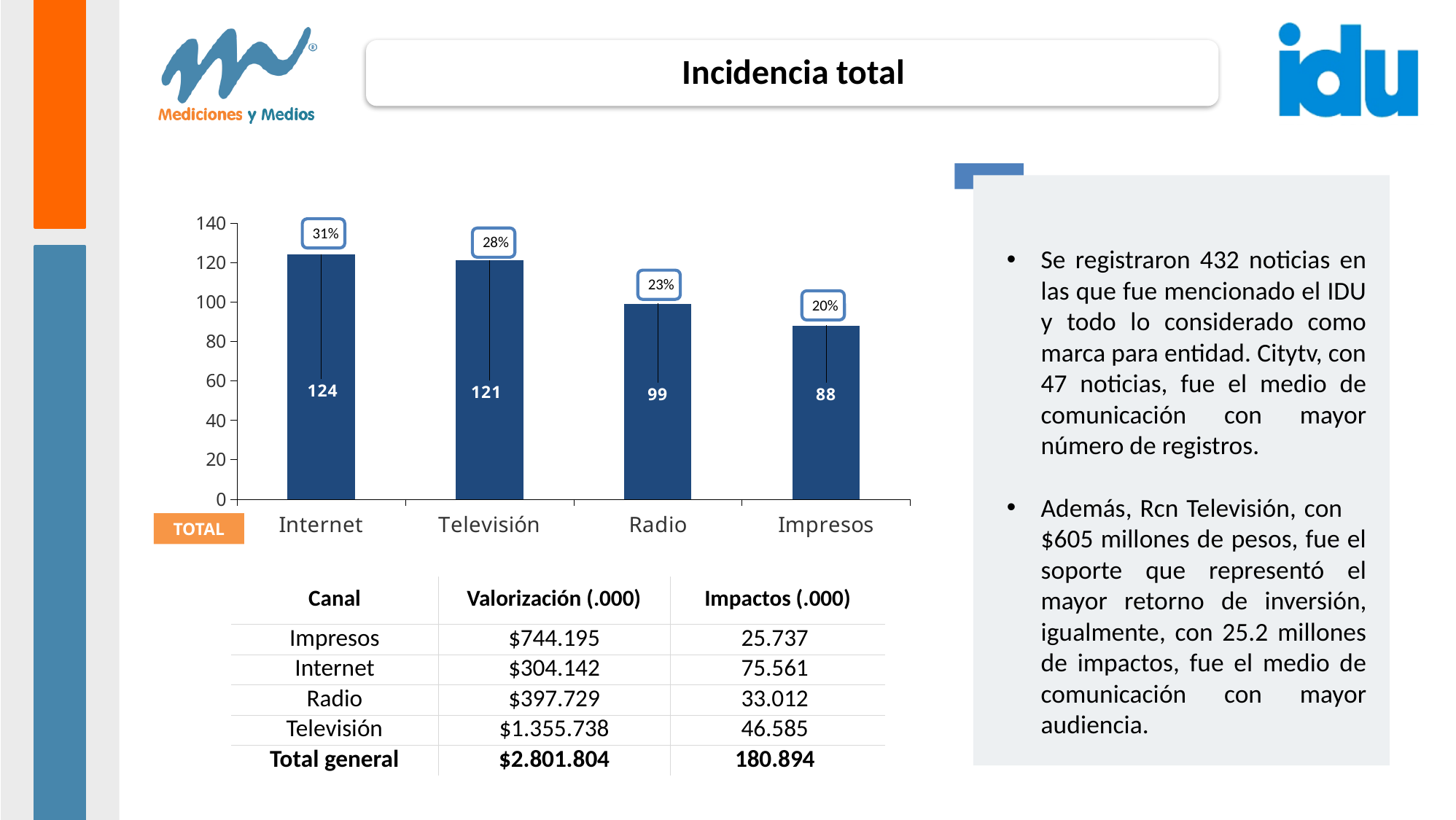
What percentage label is shown above the Impresos bar? 20% Which is larger, the value for Radio or the value for Impresos? Radio What percentage label is shown above the Televisión bar? 28% What is the difference between the values for Televisión and Radio? 22 What is the value for Internet in the bar chart? 124 Which category has the lowest value in the bar chart? Impresos What is the value for Radio in the bar chart? 99 How many categories are shown in the bar chart? 4 Which category has the highest value in the bar chart? Internet What kind of chart is shown on the slide? bar chart What is the difference between the values for Internet and Impresos? 36 Is the value for Radio greater or less than 100? less